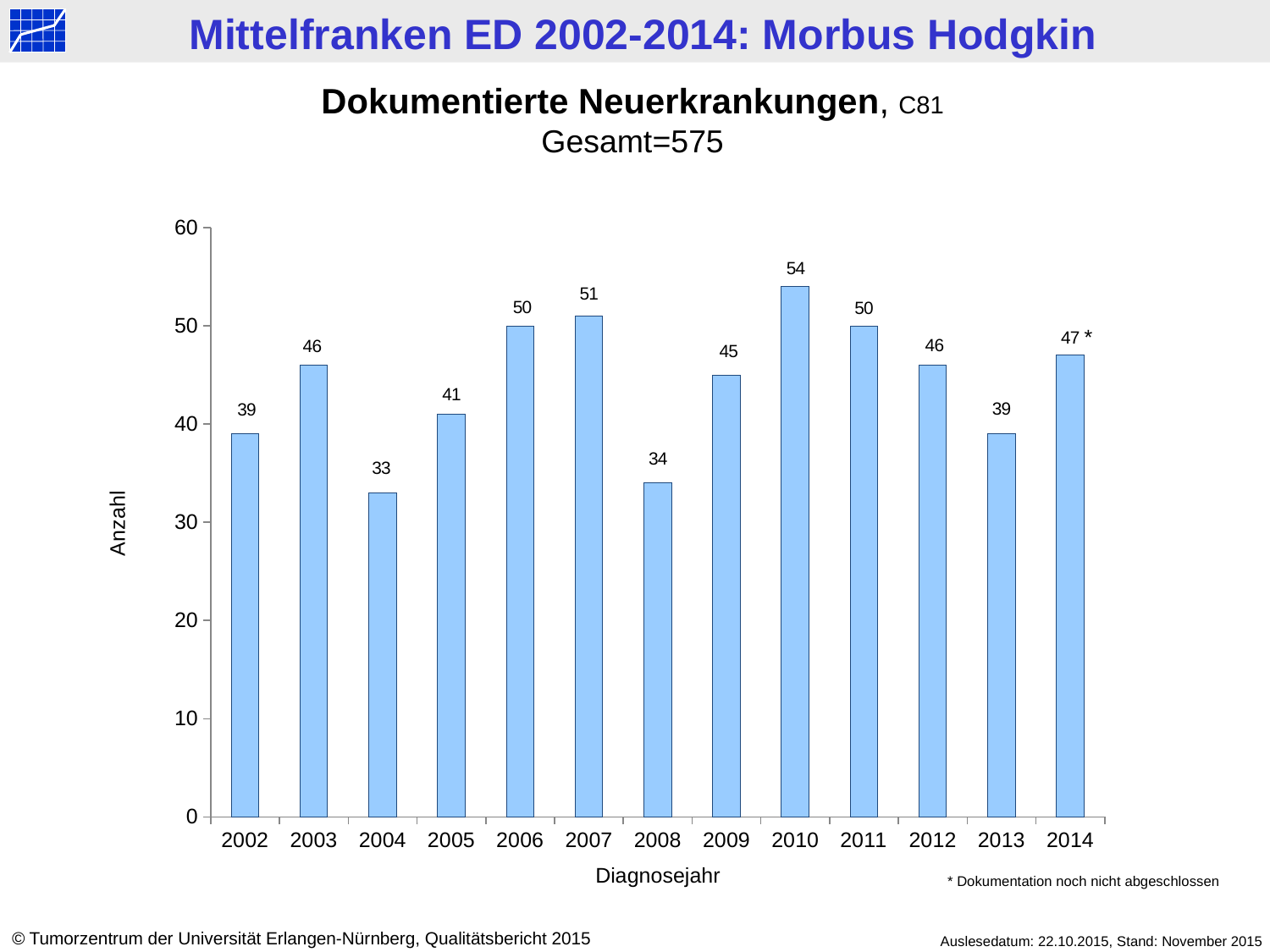
Which is larger, the value for 2007 or the value for 2009? 2007 Which year has the lowest value? 2004 What is the label of the y axis? Anzahl What is the difference between the values for 2010 and 2008? 20 Which year has the highest value? 2010 How many years are shown on the x axis? 13 What is the value for 2014? 47 What kind of chart is this? bar chart What is the value for 2010? 54 What is the total number of cases given in the chart subtitle (Gesamt)? 575 What is the value for 2004? 33 Is the value for 2006 greater or less than 40? greater